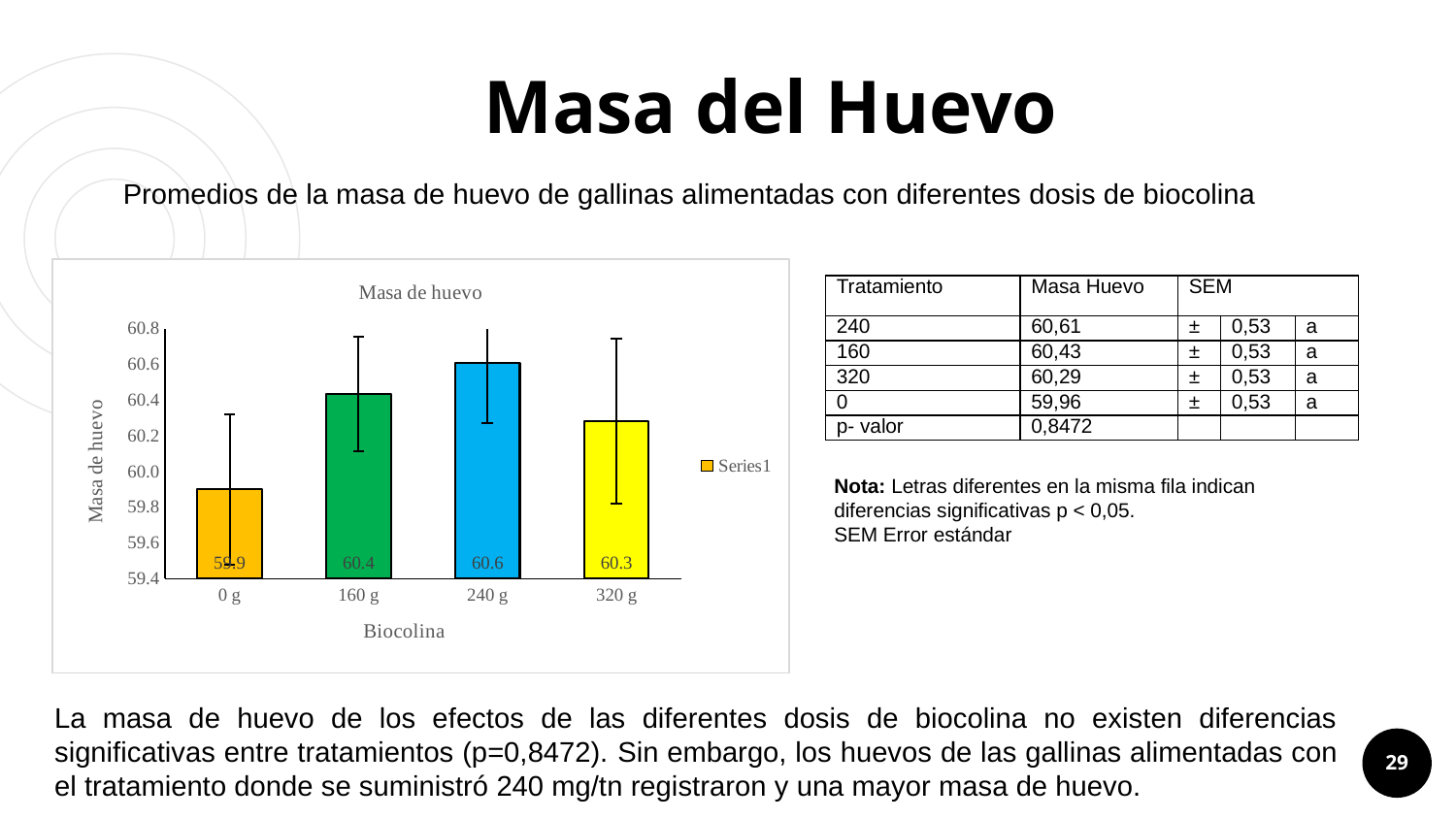
Which biocolina dose has the lowest egg mass? 0 g Which has a larger egg mass, the 160 g dose or the 0 g dose? 160 g What is the egg mass value for the 160 g biocolina dose? 60.4 Is the egg mass value for the 240 g dose greater or less than 60.4? greater What is the egg mass value for the 320 g biocolina dose? 60.3 Which biocolina dose has the highest egg mass? 240 g What is the egg mass value for the 240 g biocolina dose? 60.6 What is the title of the chart? Masa de huevo What is the difference in egg mass between the 240 g and 0 g doses? 0.7 How many biocolina dose categories are shown on the x axis? 4 What type of chart is shown on the slide? bar chart What is the egg mass value for the 0 g biocolina dose? 59.9